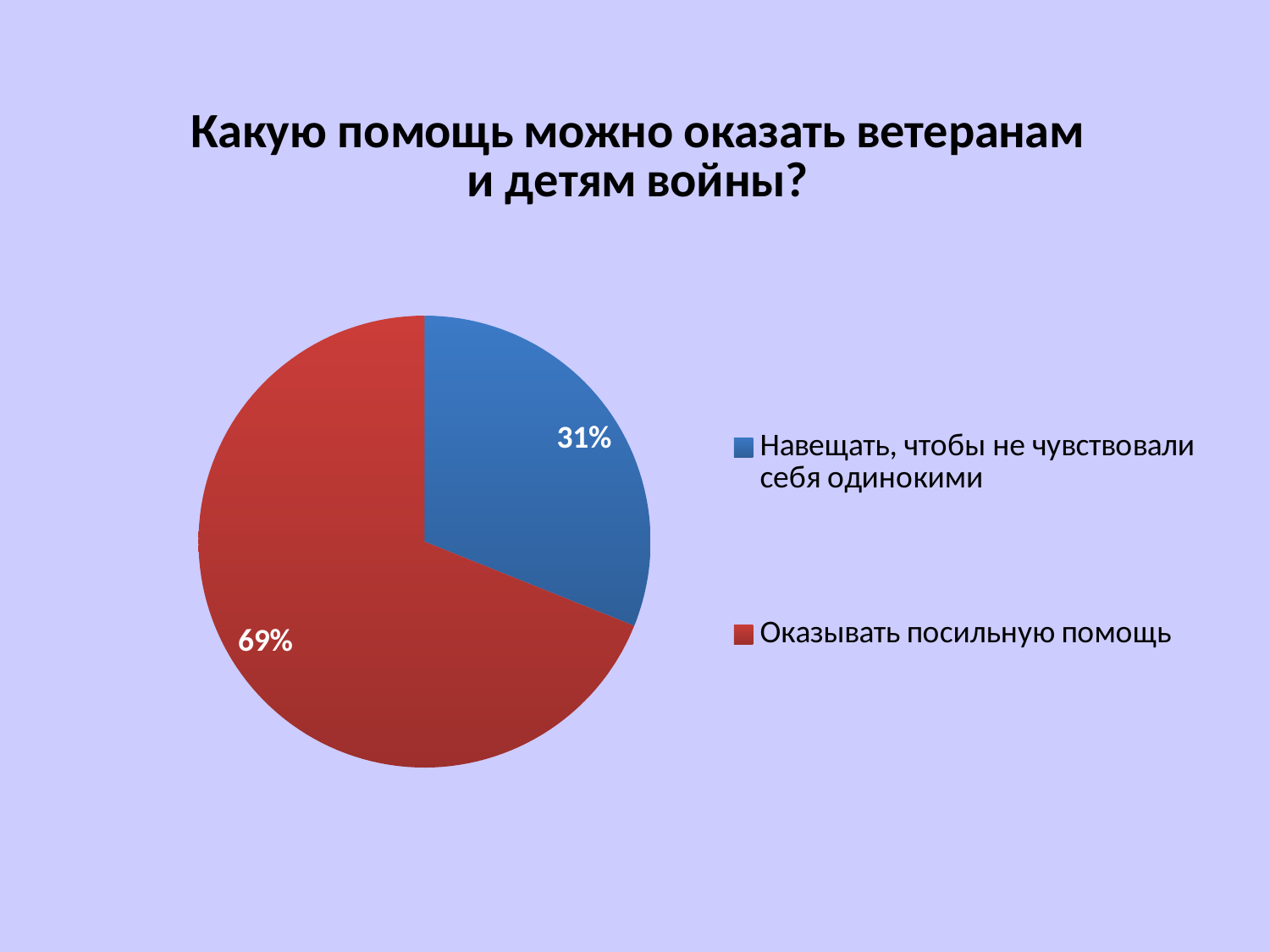
What share of the pie does the red slice represent? 69% What is the title of the chart? Какую помощь можно оказать ветеранам и детям войны? What colour is the slice for "Навещать, чтобы не чувствовали себя одинокими"? blue Which category has the smallest share of the pie? Навещать, чтобы не чувствовали себя одинокими Which is larger: the share for "Навещать, чтобы не чувствовали себя одинокими" or the share for "Оказывать посильную помощь"? Оказывать посильную помощь How many slices does the pie chart have? 2 What is the value for "Оказывать посильную помощь"? 69% What is the difference between the shares for "Оказывать посильную помощь" and "Навещать, чтобы не чувствовали себя одинокими"? 38% Which category has the largest share of the pie? Оказывать посильную помощь What kind of chart is shown on the slide? pie chart How many entries does the legend list? 2 What is the value for "Навещать, чтобы не чувствовали себя одинокими"? 31%